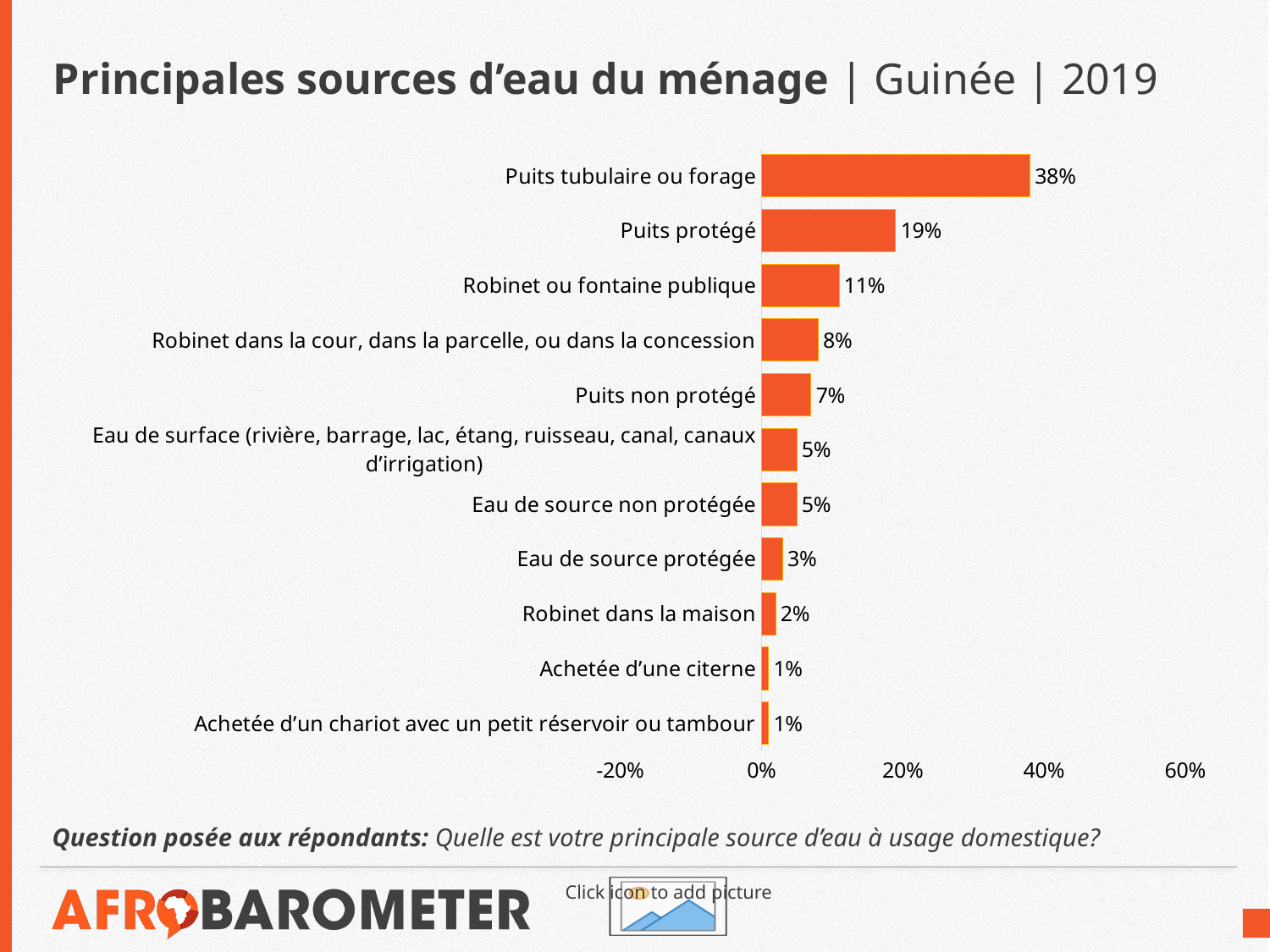
How many categories are shown in the chart? 11 What is the value for "Robinet dans la maison"? 2% Which category has the highest value? Puits tubulaire ou forage What is the title of the chart? Principales sources d'eau du ménage | Guinée | 2019 What is the value for "Puits tubulaire ou forage"? 38% What is the difference between the values for "Robinet ou fontaine publique" and "Eau de source protégée"? 8% What kind of chart is shown on the slide? bar chart What is the difference between the values for "Puits tubulaire ou forage" and "Puits protégé"? 19% Is the value for "Puits tubulaire ou forage" greater or less than 20%? greater Which is larger, the value for "Puits protégé" or the value for "Robinet dans la cour, dans la parcelle, ou dans la concession"? Puits protégé What is the value for "Robinet ou fontaine publique"? 11% What is the value for "Puits non protégé"? 7%